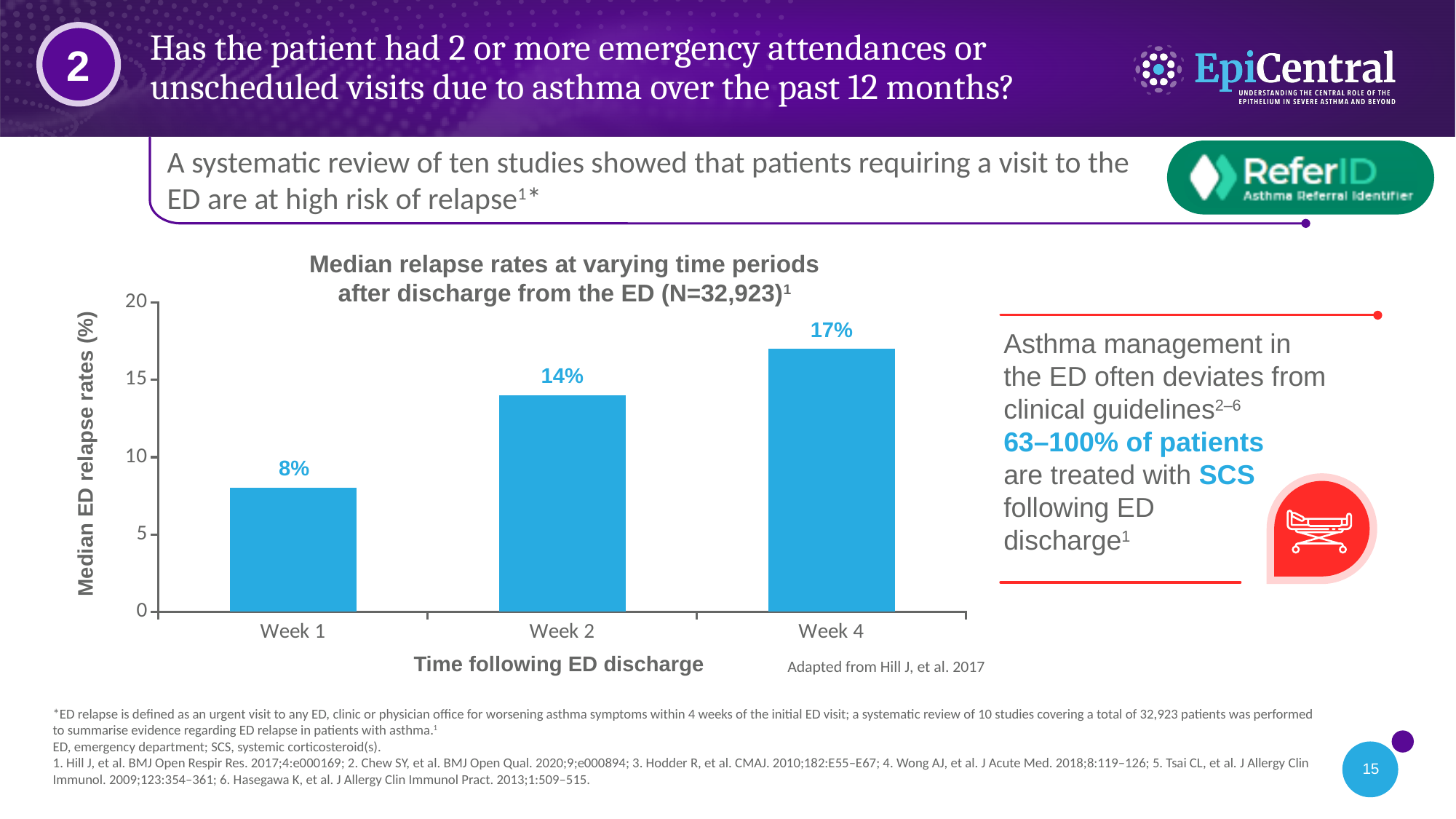
What is the difference in median ED relapse rate between Week 2 and Week 1? 6% Which has a higher median ED relapse rate, Week 2 or Week 4? Week 4 Do the median ED relapse rates rise or fall from Week 1 to Week 4? Rise What is the difference in median ED relapse rate between Week 4 and Week 1? 9% Which time period has the highest median ED relapse rate? Week 4 Which time period has the lowest median ED relapse rate? Week 1 What is the median ED relapse rate at Week 1? 8% How many time periods are shown on the x axis of the chart? 3 What is the median ED relapse rate at Week 2? 14% Is the median ED relapse rate at Week 2 greater or less than 10? greater What is the median ED relapse rate at Week 4? 17% What kind of chart is used to show median relapse rates? Bar chart